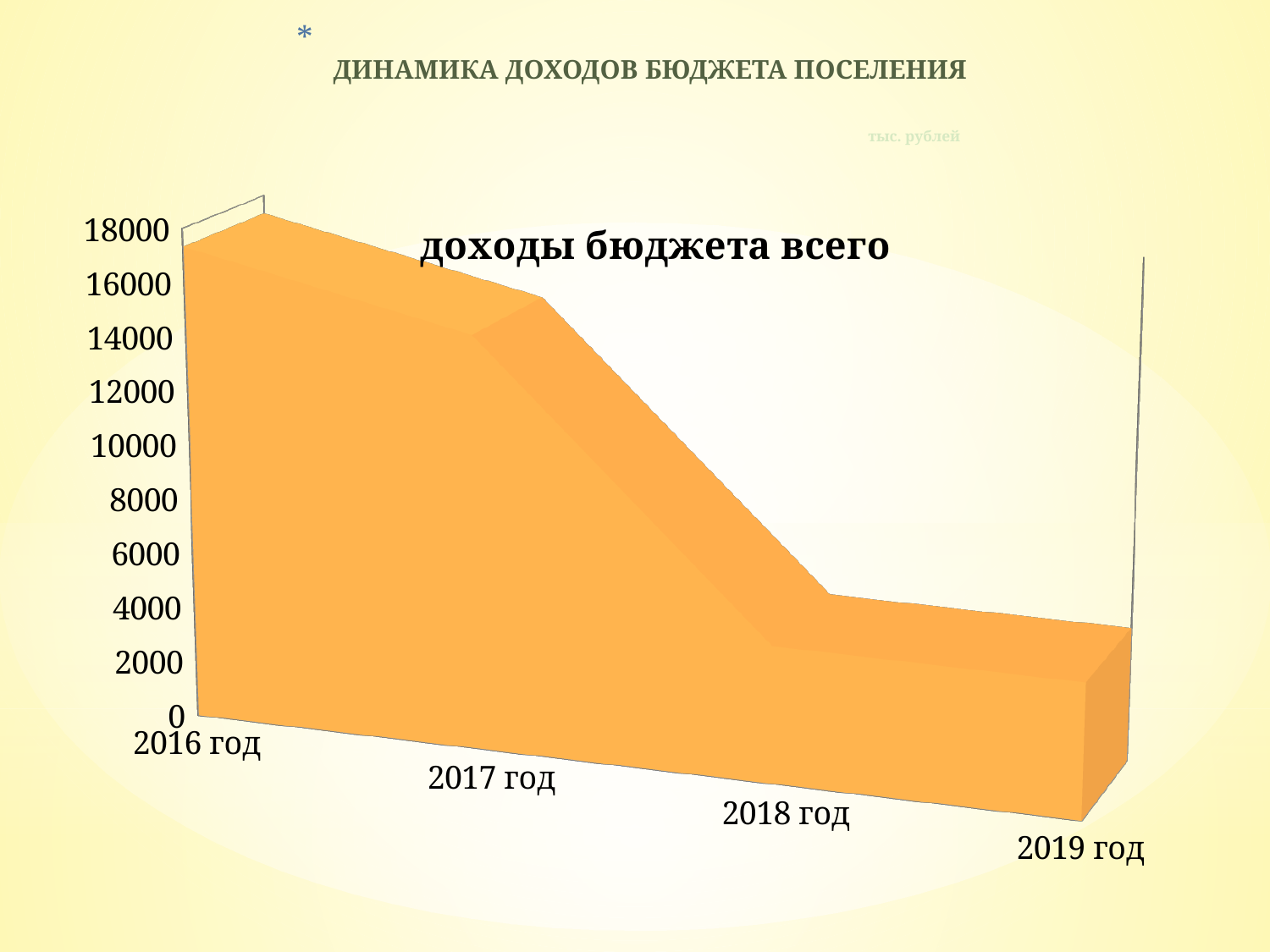
Which year has the lowest budget income in the chart? 2019 год Do the budget income values rise or fall from 2016 to 2019? fall How many years are plotted on the x axis of the chart? 4 What is the title shown inside the chart area? доходы бюджета всего Is the value for 2018 год greater or less than 6000? less In what units are the chart values given, according to the slide? тыс. рублей Is the value for 2017 год greater or less than 14000? greater Is the value for 2016 год greater or less than 16000? greater What kind of chart is shown on the slide? area chart Which year has the highest budget income in the chart? 2016 год Which is larger, the value for 2017 год or the value for 2018 год? 2017 год